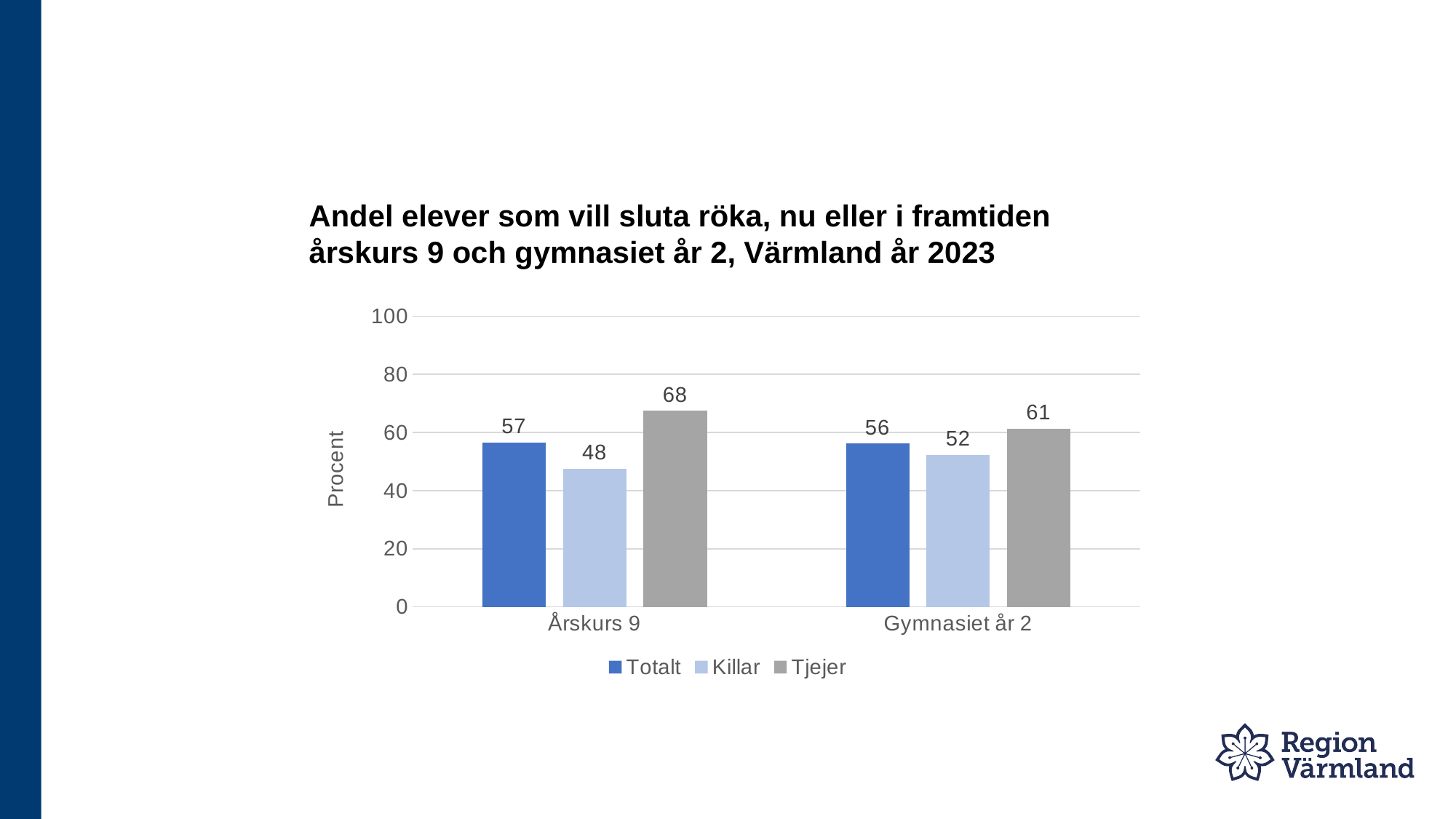
How many categories are shown on the x axis? 2 Which series has the lowest value in Årskurs 9? Killar Which series has the highest value in Gymnasiet år 2? Tjejer How many series does the legend list? 3 What is the difference between Tjejer and Killar in Årskurs 9? 20 What is the value for Killar in Gymnasiet år 2? 52 What is the value for Tjejer in Årskurs 9? 68 What is the Totalt value for Årskurs 9? 57 What kind of chart is shown on the slide? Bar chart Which is larger: Killar in Årskurs 9 or Killar in Gymnasiet år 2? Killar in Gymnasiet år 2 What is the difference between the Totalt values for Årskurs 9 and Gymnasiet år 2? 1 What is the label of the y axis? Procent